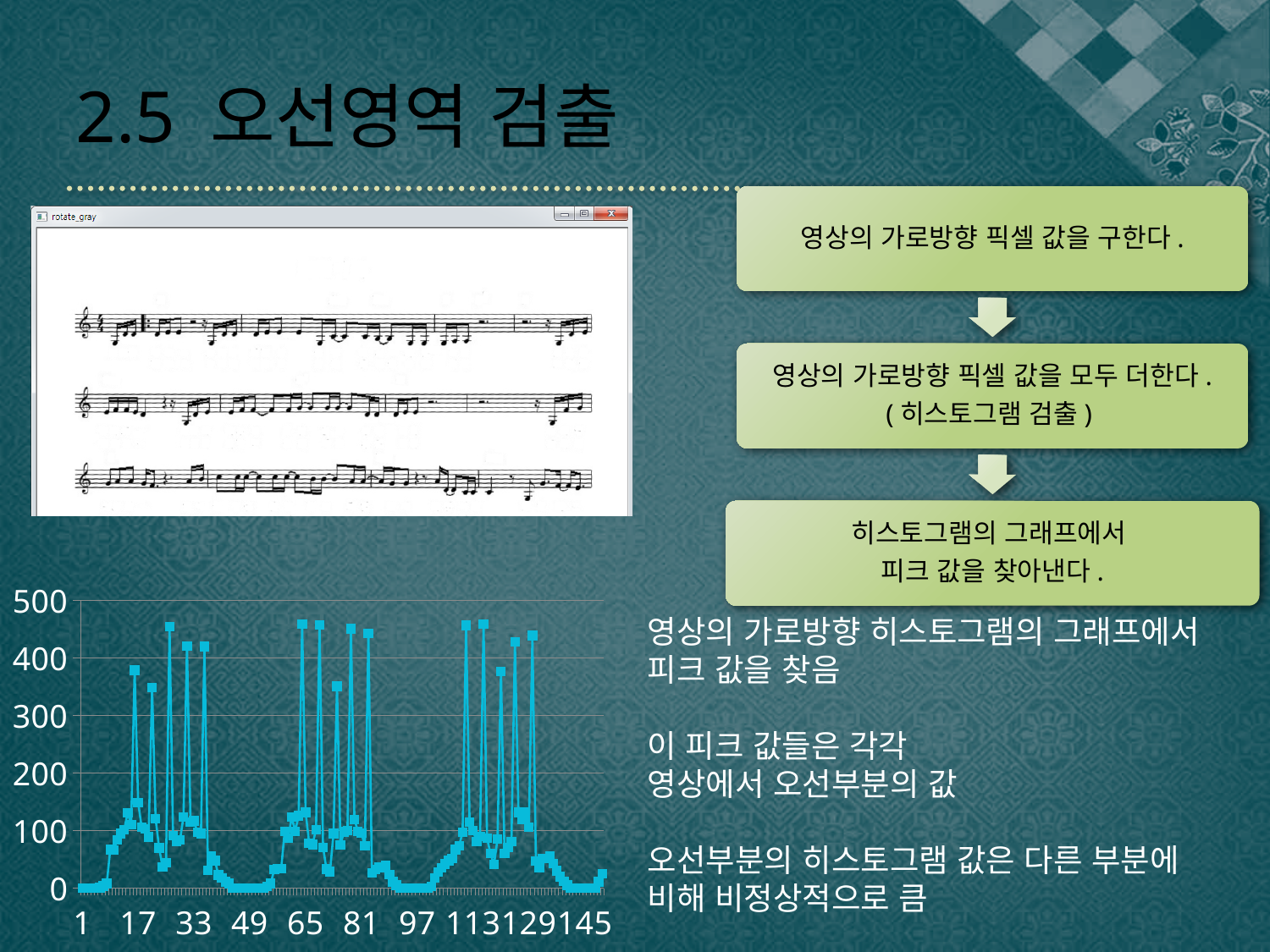
Is the value at x = 97 on the chart greater or less than 100? less What is the interval between consecutive y-axis tick labels on the chart? 100 Do the tallest peaks on the chart rise above 400? yes What is the last label shown on the x axis of the chart? 145 What is the highest value shown on the y axis of the chart? 500 Is the value at x = 49 on the chart greater or less than 100? less How many tick labels are shown on the x axis of the chart? 10 What kind of chart is shown at the bottom left of the slide? line chart